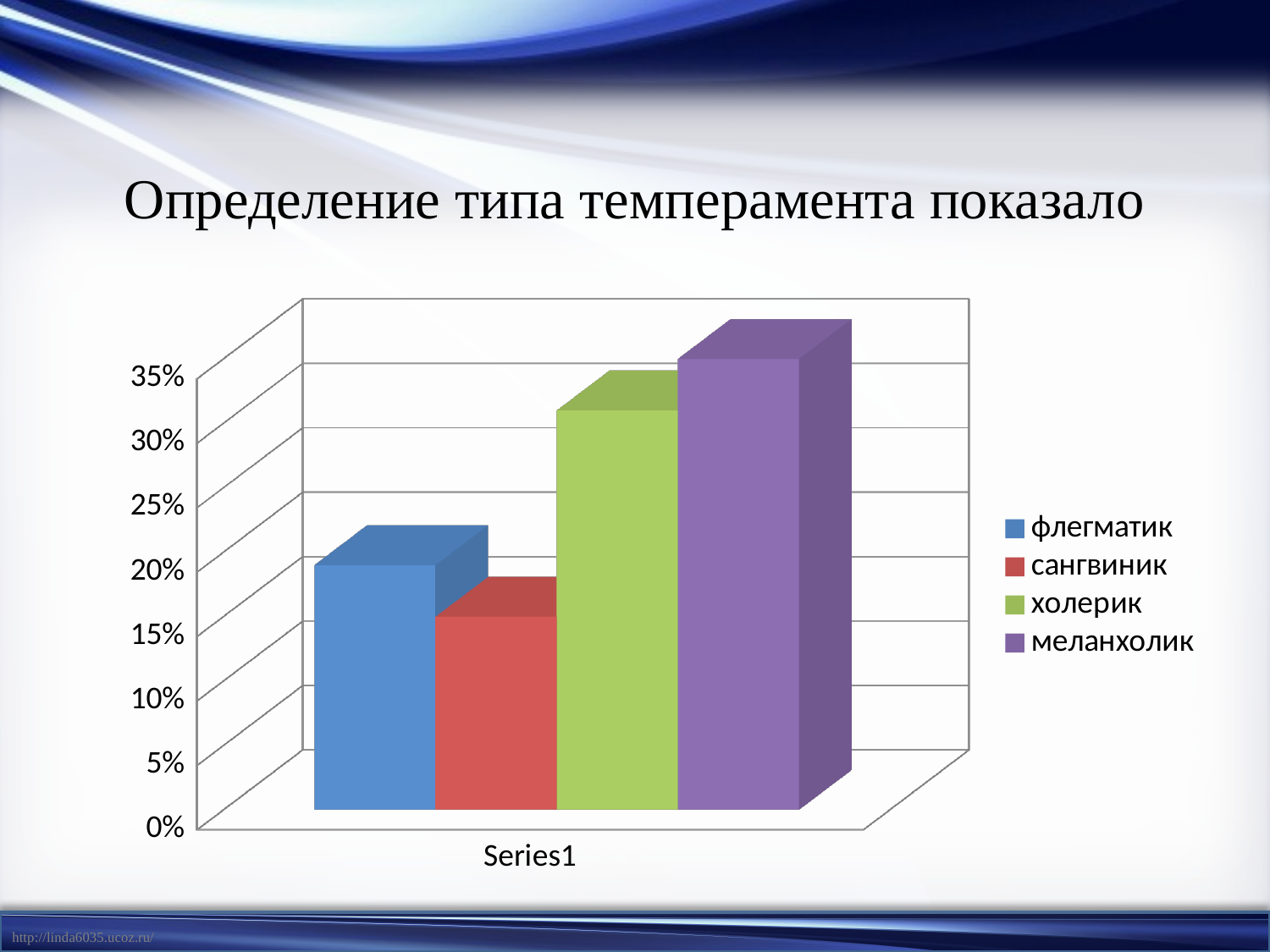
How many entries does the legend list? 4 Is the value for сангвиник greater or less than 20%? less What colour is the bar for меланхолик? purple Is the value for холерик greater or less than 25%? greater How many bars are plotted in the chart? 4 Is the value for меланхолик greater or less than 30%? greater Which is larger, the value for холерик or the value for флегматик? холерик Which temperament type has the highest bar? меланхолик What is the title of the slide above the chart? Определение типа темперамента показало Which temperament type has the lowest bar? сангвиник What kind of chart is shown on the slide? bar chart